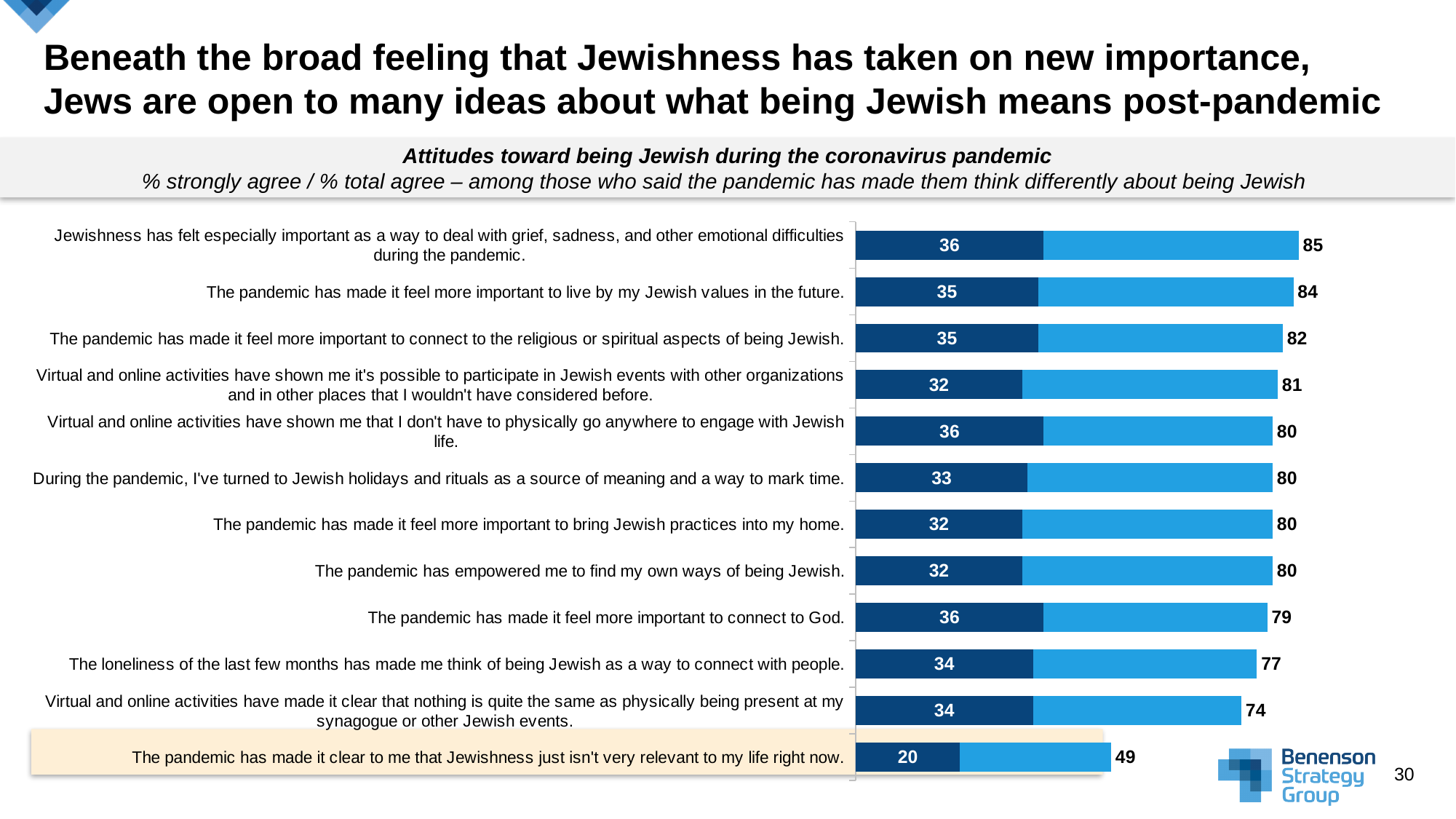
What is the % strongly agree for "Virtual and online activities have shown me it's possible to participate in Jewish events with other organizations and in other places that I wouldn't have considered before."? 32 What is the difference in % total agree between "The loneliness of the last few months has made me think of being Jewish as a way to connect with people." and "Virtual and online activities have made it clear that nothing is quite the same as physically being present at my synagogue or other Jewish events."? 3 Which has a higher % total agree: "The pandemic has made it feel more important to connect to the religious or spiritual aspects of being Jewish." or "The pandemic has empowered me to find my own ways of being Jewish."? The pandemic has made it feel more important to connect to the religious or spiritual aspects of being Jewish. What is the title of the chart? Attitudes toward being Jewish during the coronavirus pandemic What is the % strongly agree for "During the pandemic, I've turned to Jewish holidays and rituals as a source of meaning and a way to mark time."? 33 How many statements are plotted in the chart? 12 Which statement has the highest % total agree? Jewishness has felt especially important as a way to deal with grief, sadness, and other emotional difficulties during the pandemic. What is the % total agree for "The pandemic has made it feel more important to connect to God."? 79 What is the % total agree for "The pandemic has made it clear to me that Jewishness just isn't very relevant to my life right now."? 49 What is the difference between the % total agree and the % strongly agree for "The pandemic has made it feel more important to live by my Jewish values in the future."? 49 Which statement has the lowest % strongly agree? The pandemic has made it clear to me that Jewishness just isn't very relevant to my life right now. What kind of chart is shown on the slide? bar chart